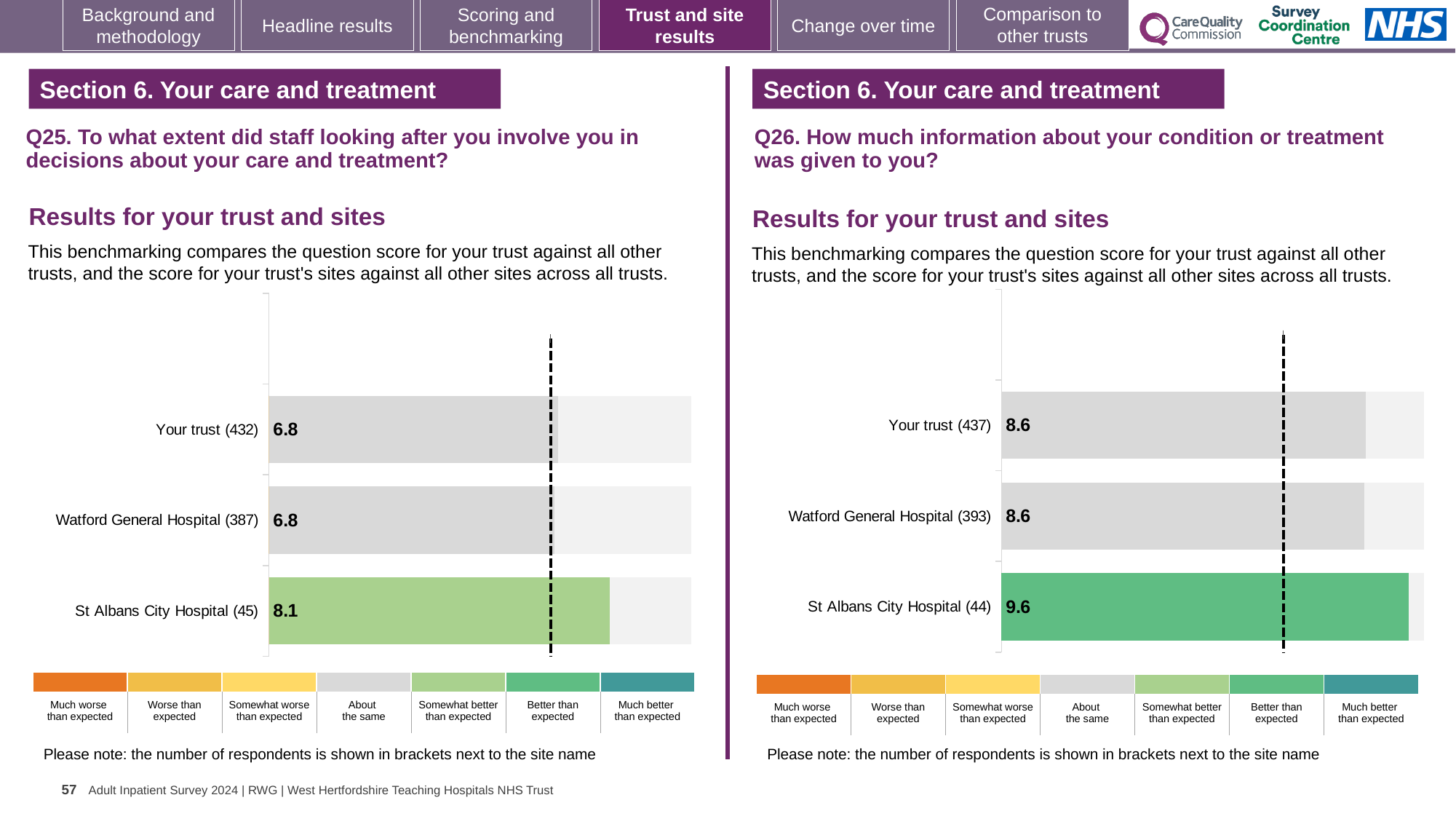
In the Q25 chart on the left, which site or trust has the highest score? St Albans City Hospital In the Q26 chart on the right, what is the score for Watford General Hospital? 8.6 In the Q25 chart on the left, how many respondents are shown in brackets for St Albans City Hospital? 45 In the Q26 chart on the right, what is the difference between the scores for St Albans City Hospital and Your trust? 1.0 In the Q25 chart on the left, is the score for St Albans City Hospital larger or smaller than the score for Your trust? larger In the Q25 chart on the left, what is the difference between the scores for St Albans City Hospital and Watford General Hospital? 1.3 In the Q26 chart on the right, what is the score for St Albans City Hospital? 9.6 In the Q25 chart on the left, what is the score for St Albans City Hospital? 8.1 What kind of chart is used for the Q25 results on the left? bar chart In the Q25 chart on the left, what is the score for Your trust? 6.8 How many bars are plotted in the Q26 chart on the right? 3 In the Q26 chart on the right, which site or trust has the highest score? St Albans City Hospital